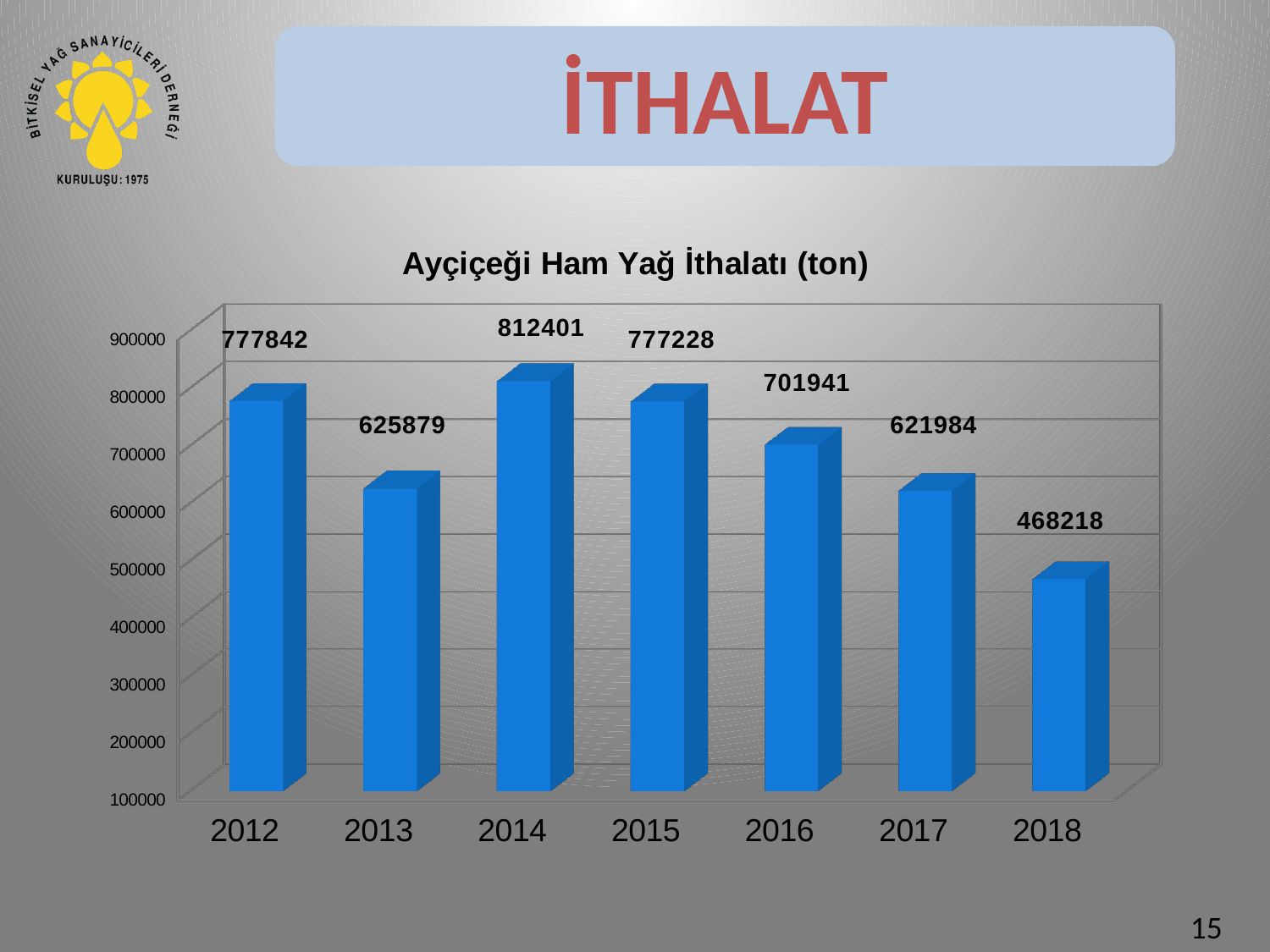
What is the value for 2018 in the chart? 468218 What is the title of the chart? Ayçiçeği Ham Yağ İthalatı (ton) Which year has the highest value in the chart? 2014 Which is larger, the value for 2016 or the value for 2017? 2016 Is the value for 2018 greater or less than 500000? less What is the difference between the values for 2012 and 2013? 151963 What is the value for 2016 in the chart? 701941 What is the difference between the values for 2014 and 2018? 344183 How many years are shown on the x axis of the chart? 7 Which year has the lowest value in the chart? 2018 What kind of chart is shown on the slide? bar chart What is the value for 2014 in the chart? 812401